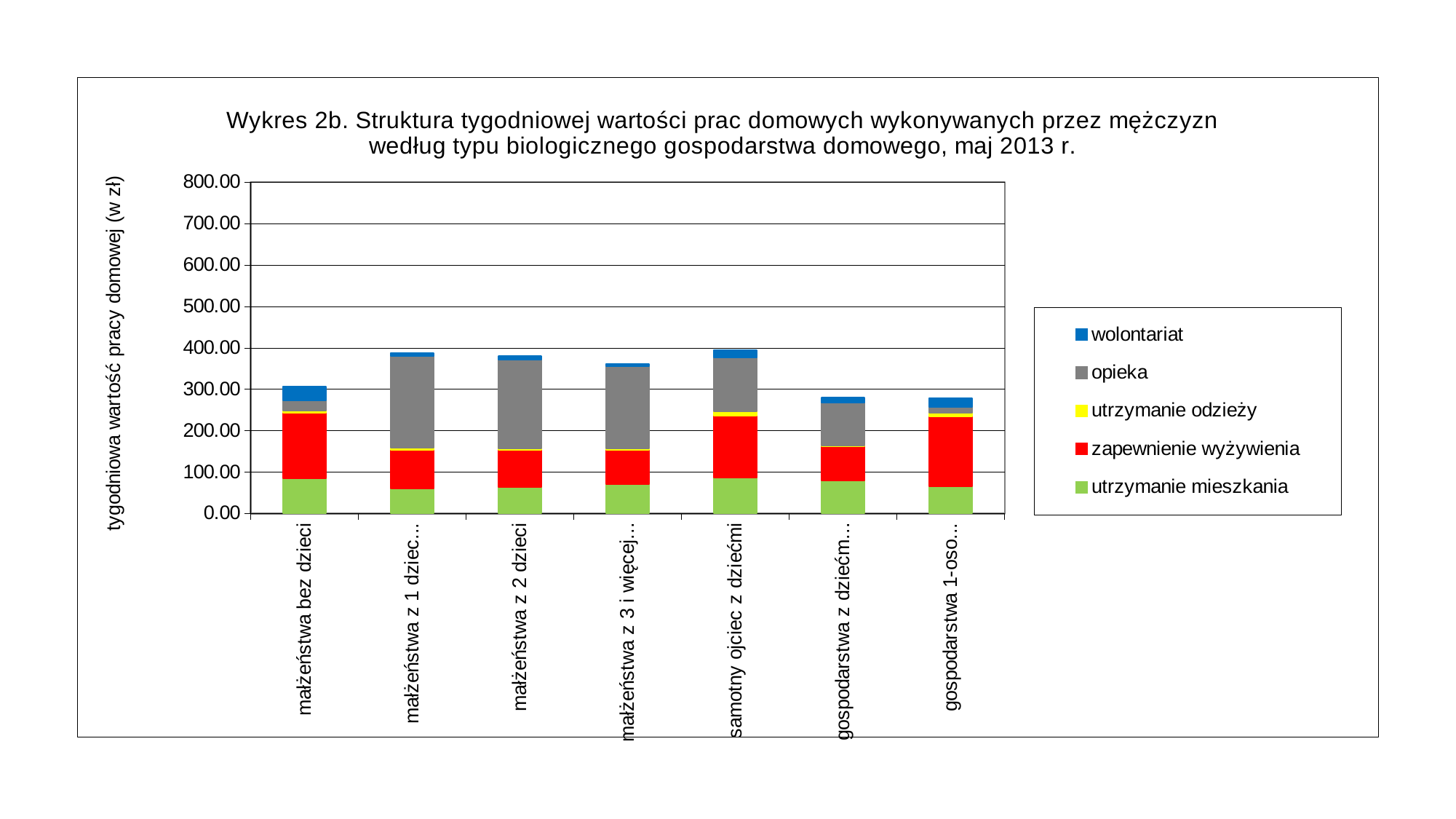
What kind of chart is shown on the slide? stacked bar chart Which has the larger opieka segment: małżeństwa bez dzieci or małżeństwa z 2 dzieci? małżeństwa z 2 dzieci Which has the larger total value: małżeństwa bez dzieci or małżeństwa z 2 dzieci? małżeństwa z 2 dzieci How many series does the legend list? 5 Is the total value for małżeństwa z 2 dzieci greater or less than 300? greater Is the total value for małżeństwa bez dzieci greater or less than 400? less Is the utrzymanie mieszkania value for małżeństwa bez dzieci greater or less than 100? less What is the label of the y axis? tygodniowa wartość pracy domowej (w zł) Which series is shown in grey in the legend? opieka How many household-type categories are plotted along the x axis? 7